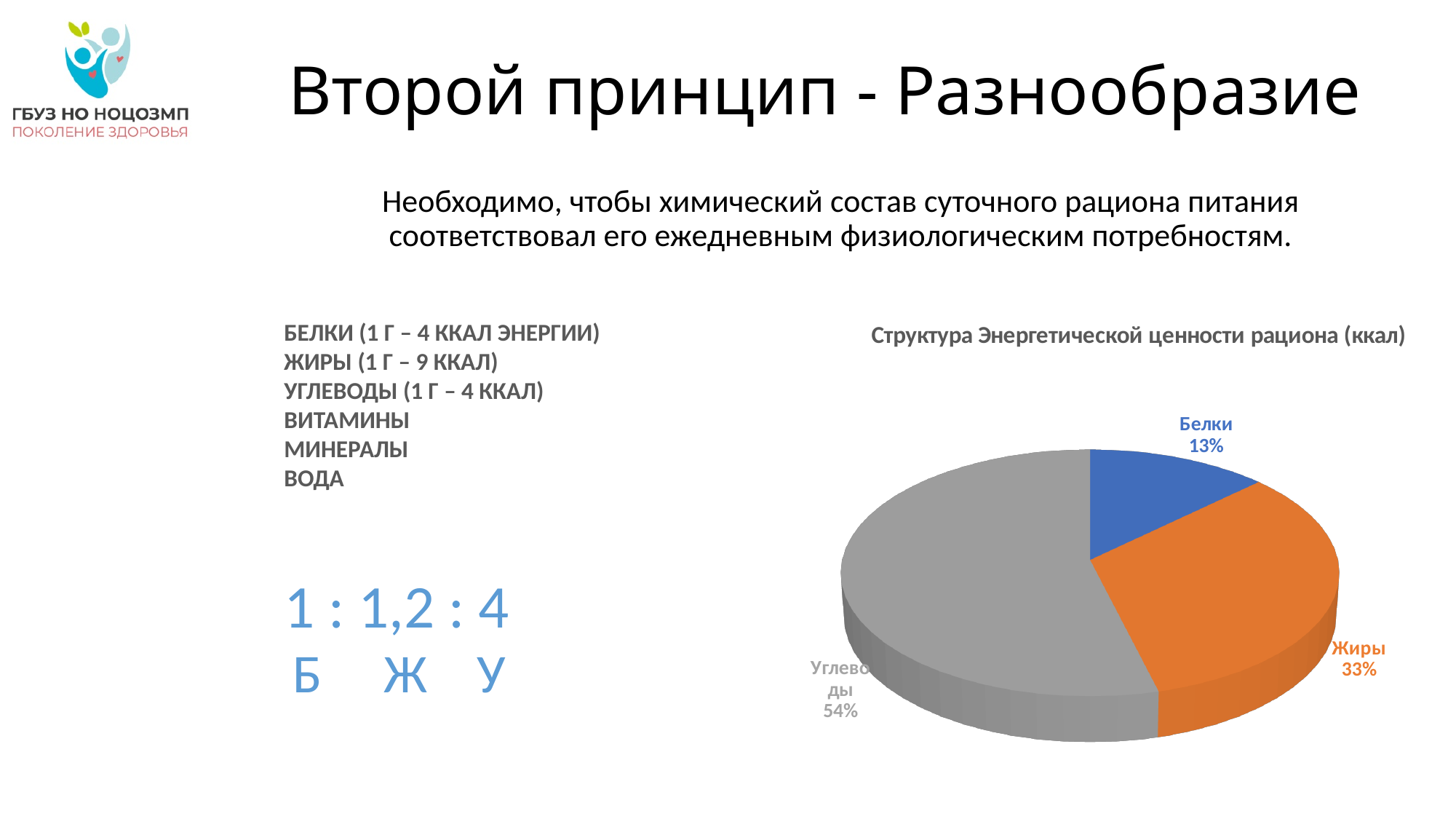
What share of the pie chart does Белки represent? 13% Which category has the largest slice in the pie chart? Углеводы What kind of chart is shown on the slide? Pie chart How many slices does the pie chart have? 3 What colour is the Жиры slice in the pie chart? Orange What is the title of the chart? Структура Энергетической ценности рациона (ккал) What is the difference in percentage points between the Жиры and Белки slices? 20% What is the difference in percentage points between the Углеводы and Жиры slices? 21% What share of the pie chart does Углеводы represent? 54% Which slice is larger, Жиры or Белки? Жиры Which category has the smallest slice in the pie chart? Белки What share of the pie chart does Жиры represent? 33%